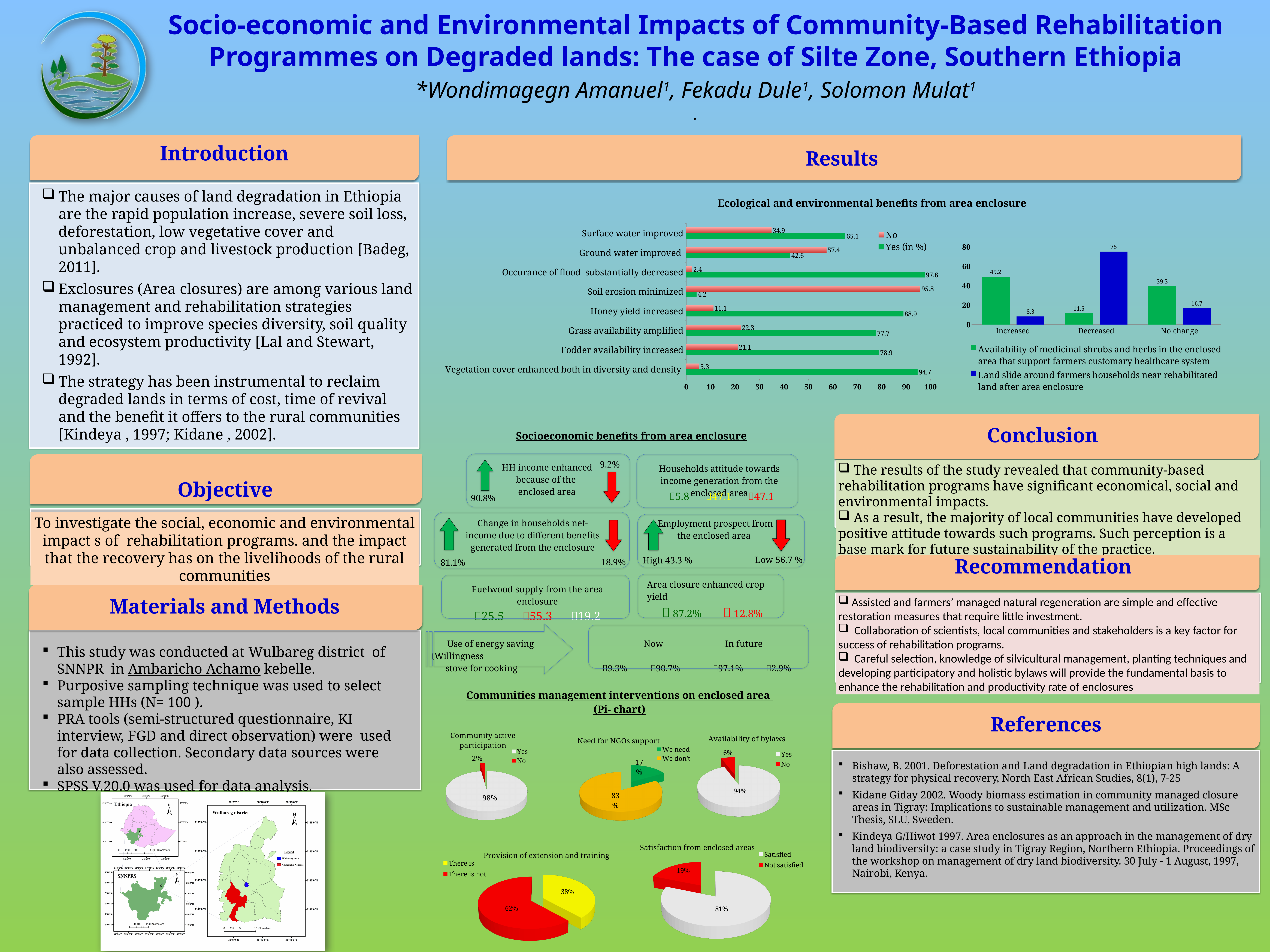
In the 'Ecological and environmental benefits from area enclosure' bar chart, what is the 'No' value for 'Surface water improved'? 34.9 In the 'Need for NGOs support' pie chart, what share is 'We don't'? 83% In the 'Ecological and environmental benefits from area enclosure' bar chart, what is the 'Yes' value for 'Occurance of flood substantially decreased'? 97.6 In the 'Ecological and environmental benefits from area enclosure' bar chart, what is the difference between the 'Yes' and 'No' values for 'Honey yield increased'? 77.8 In the vertical bar chart with categories Increased, Decreased and No change, what is the value of the blue 'Land slide' series for 'Decreased'? 75 In the 'Ecological and environmental benefits from area enclosure' bar chart, how many categories are listed on the vertical axis? 8 In the 'Ecological and environmental benefits from area enclosure' bar chart, how many series does the legend list? 2 In the vertical bar chart with categories Increased, Decreased and No change, is the green series value for 'No change' larger or the blue series value for 'No change'? Green (39.3) In the 'Ecological and environmental benefits from area enclosure' bar chart, which category has the lowest 'Yes' value? Soil erosion minimized In the 'Satisfaction from enclosed areas' pie chart, what percentage is 'Not satisfied'? 19% What type of chart is used for 'Provision of extension and training'? Pie chart In the vertical bar chart with categories Increased, Decreased and No change, which category has the highest value for the green 'Availability of medicinal shrubs and herbs' series? Increased